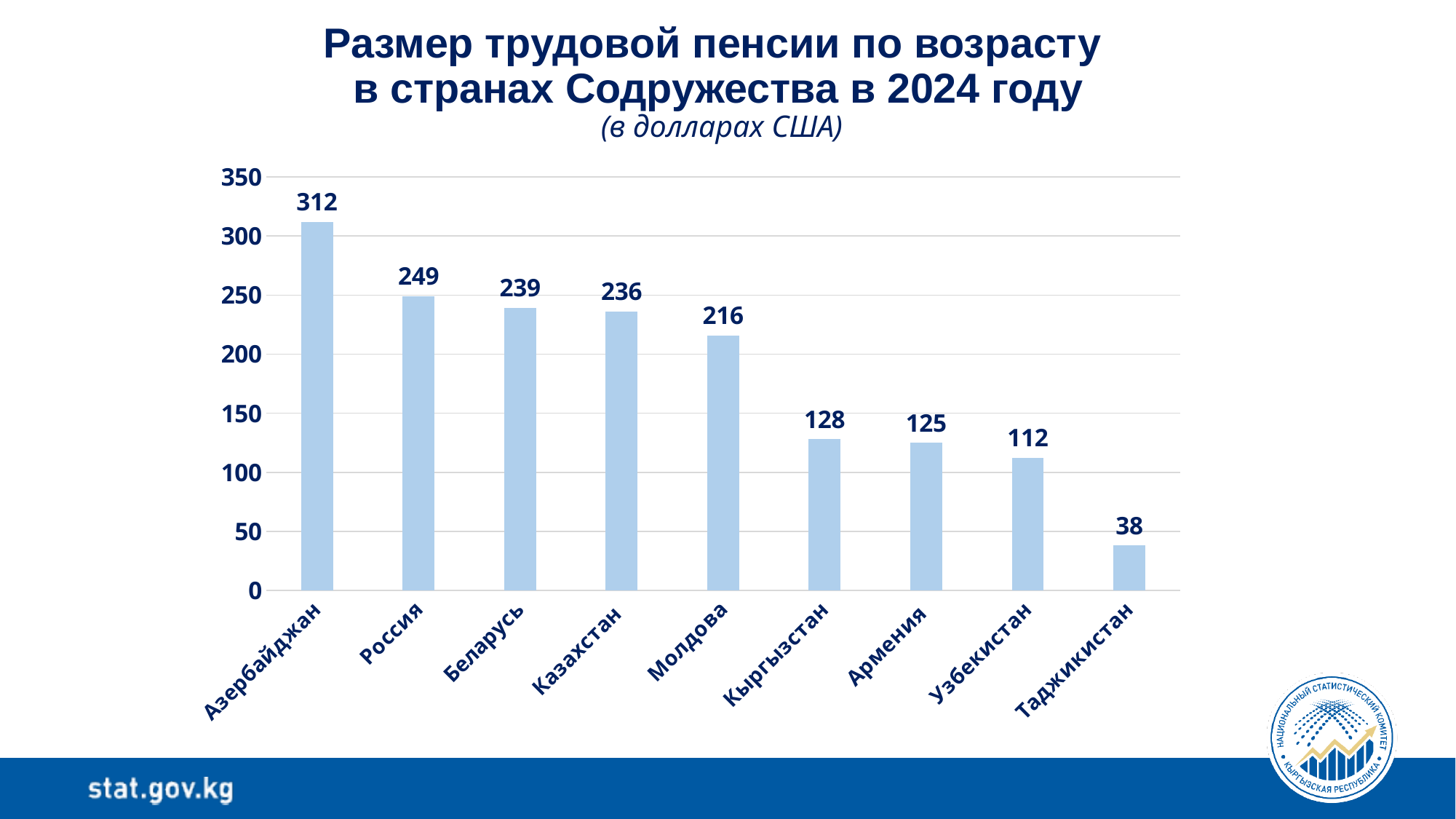
What kind of chart is shown on the slide? bar chart What is the value for Кыргызстан? 128 Do the values rise or fall from left to right along the x axis? fall What is the value for Таджикистан? 38 Which country has the lowest value? Таджикистан How many countries are shown on the chart? 9 Which is larger, the value for Беларусь or the value for Молдова? Беларусь What is the difference between the values for Азербайджан and Россия? 63 Which country has the highest value? Азербайджан What is the difference between the values for Молдова and Узбекистан? 104 Is the value for Армения greater or less than 150? less What is the value for Россия? 249